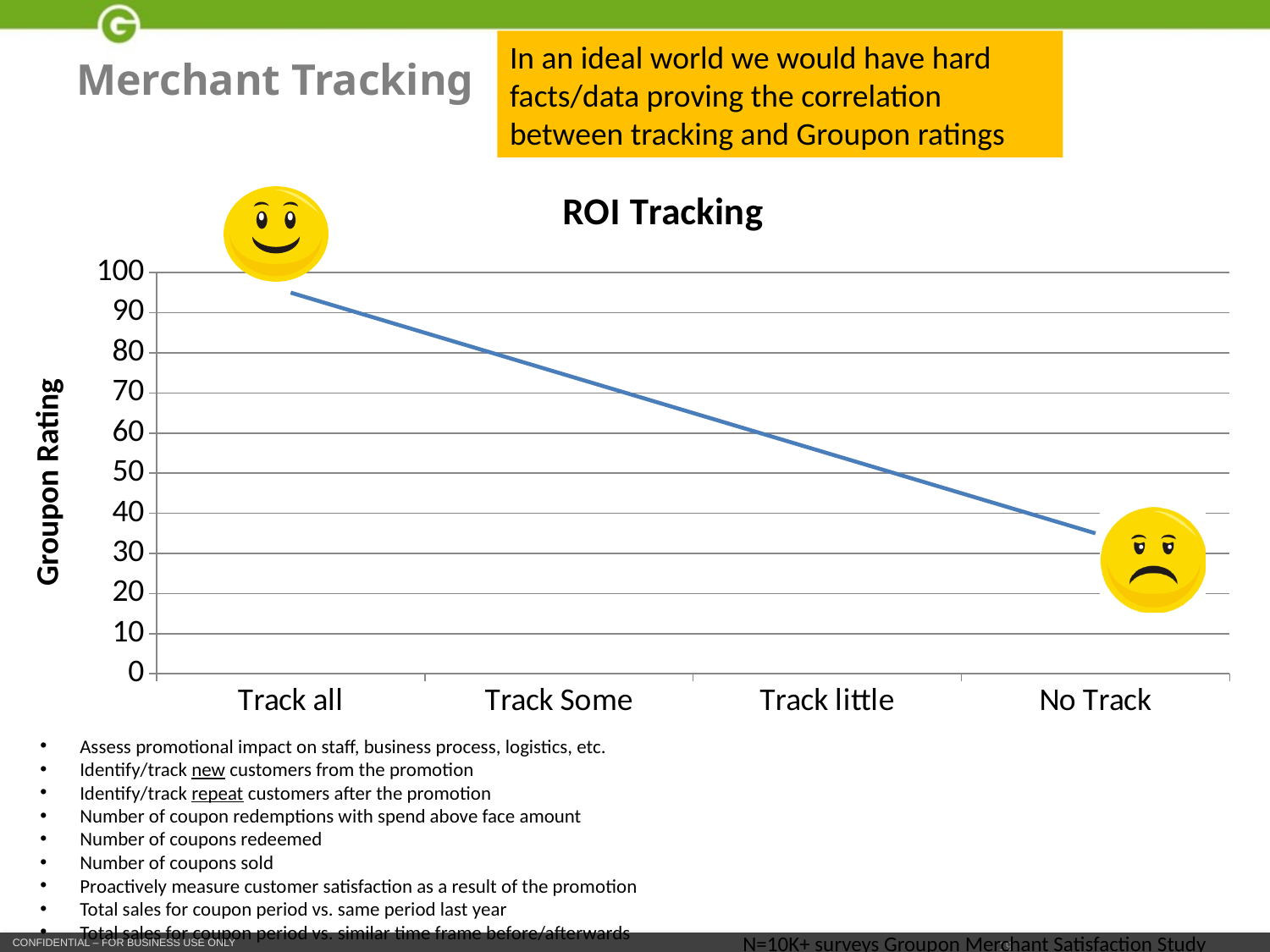
Is the value for Track little greater or less than 60? less What is the title of the chart? ROI Tracking Which has the larger Groupon Rating, Track Some or Track little? Track Some What is the label on the vertical axis of the chart? Groupon Rating Do the values rise or fall along the x axis from Track all to No Track? fall Is the value for Track all greater or less than 90? greater Is the value for Track Some greater or less than 70? greater Which category has the lowest Groupon Rating? No Track How many categories are shown on the x axis of the chart? 4 What kind of chart is shown on the slide? line chart Which category has the highest Groupon Rating? Track all